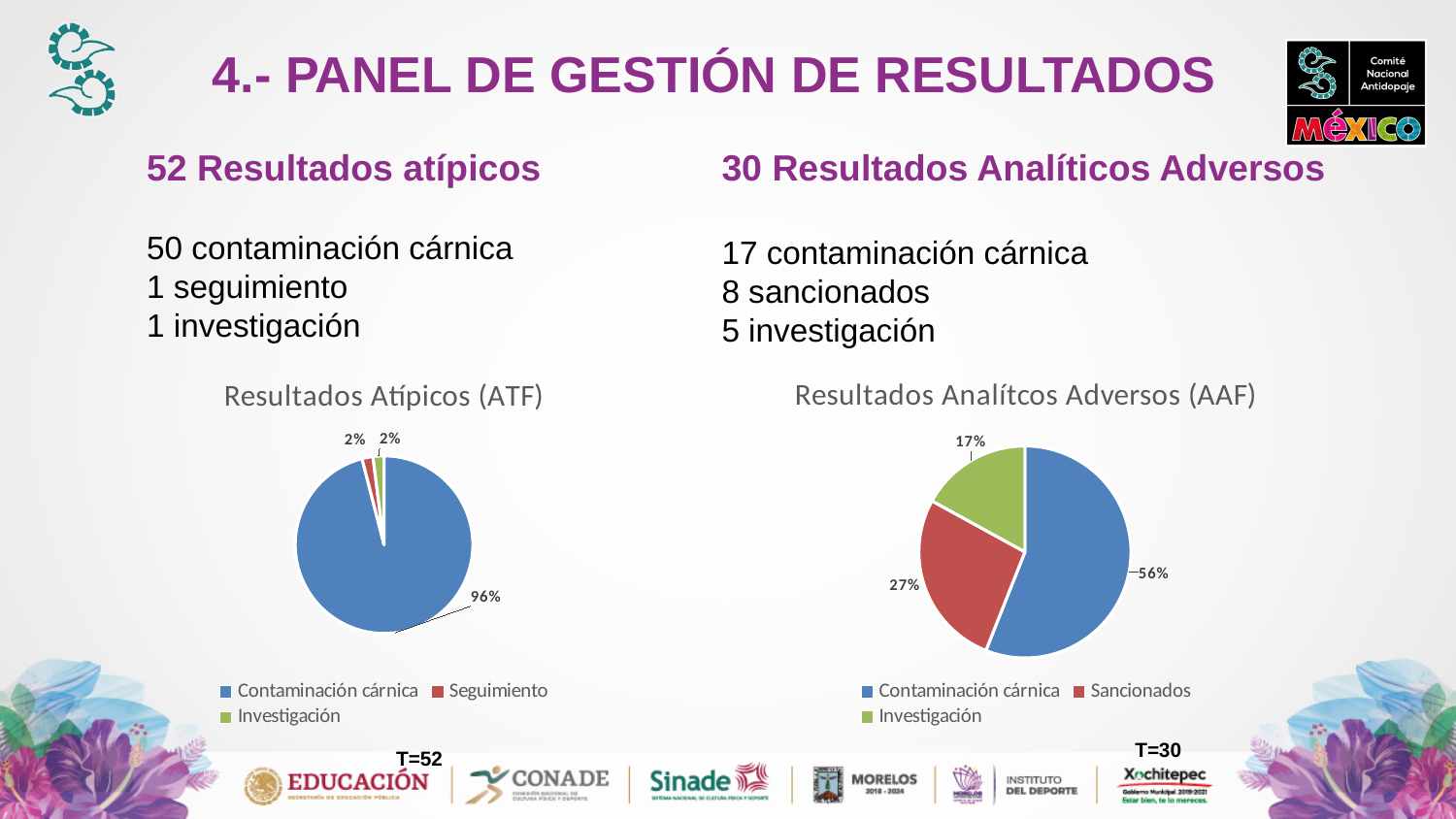
How many categories does the 'Resultados Atípicos (ATF)' chart show? 3 In the 'Resultados Analítcos Adversos (AAF)' chart, which category has the smallest slice? Investigación In the 'Resultados Atípicos (ATF)' chart, what share does Contaminación cárnica have? 96% In the 'Resultados Analítcos Adversos (AAF)' chart, which category has the largest slice? Contaminación cárnica In the 'Resultados Analítcos Adversos (AAF)' chart, what share does Investigación have? 17% In the 'Resultados Atípicos (ATF)' chart, which category has the largest slice? Contaminación cárnica In the 'Resultados Analítcos Adversos (AAF)' chart, what share does Sancionados have? 27% In the 'Resultados Analítcos Adversos (AAF)' chart, what is the difference in percentage points between Sancionados and Investigación? 10 What type of chart is 'Resultados Analítcos Adversos (AAF)'? Pie chart What are the legend entries of the 'Resultados Atípicos (ATF)' chart? Contaminación cárnica, Seguimiento, Investigación In the 'Resultados Analítcos Adversos (AAF)' chart, which is larger, Sancionados or Investigación? Sancionados